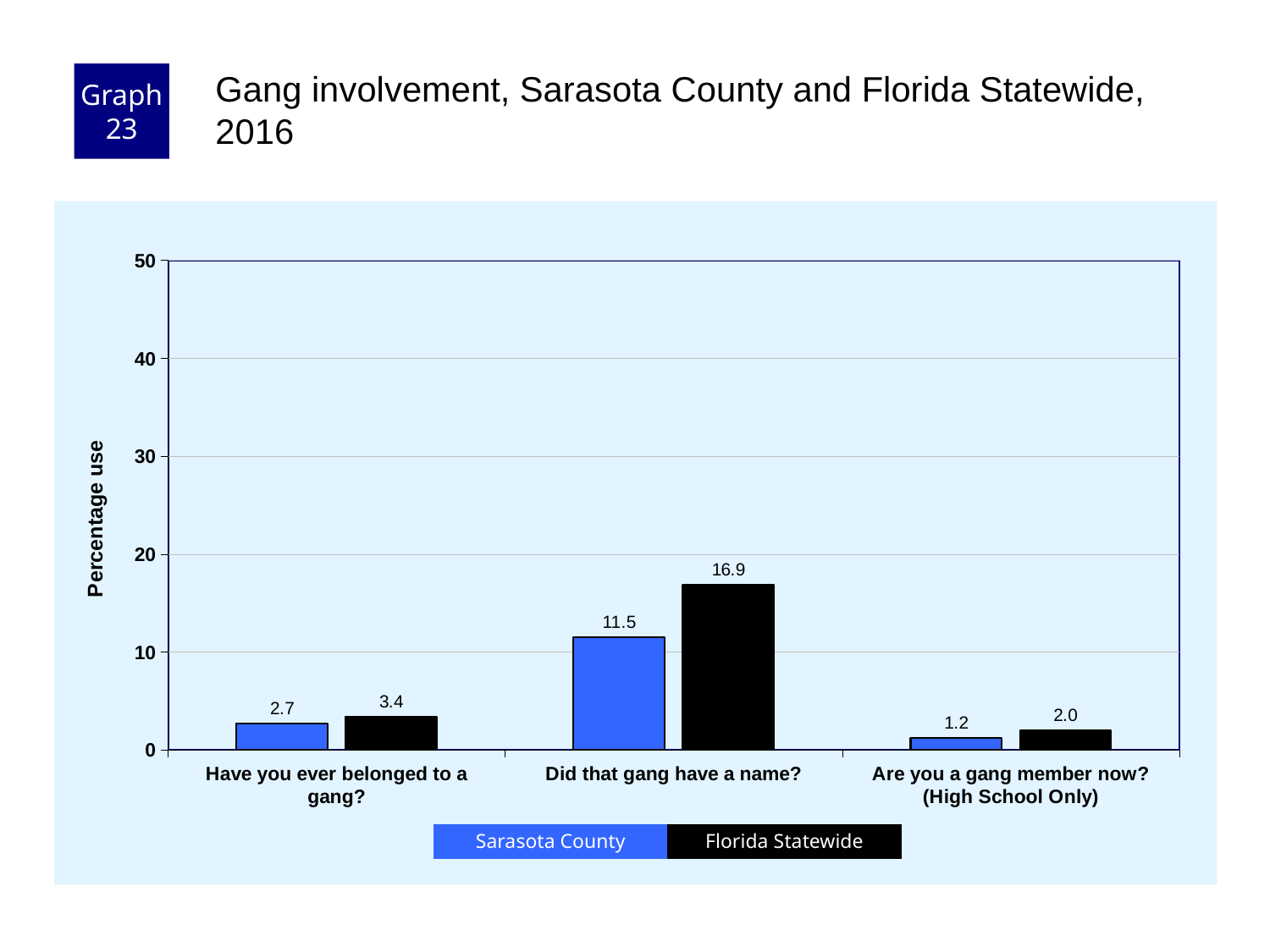
For "Have you ever belonged to a gang?", which is larger: Sarasota County or Florida Statewide? Florida Statewide Which question has the lowest Sarasota County value? Are you a gang member now? (High School Only) How many series does the legend list? 2 What is the Sarasota County value for "Did that gang have a name?"? 11.5 Is the Florida Statewide value for "Did that gang have a name?" greater or less than 20? less What is the Sarasota County value for "Are you a gang member now? (High School Only)"? 1.2 What kind of chart is shown? bar chart What is the difference between the Florida Statewide and Sarasota County values for "Did that gang have a name?"? 5.4 What is the label on the y axis? Percentage use How many questions (categories) are shown on the x axis? 3 What is the Florida Statewide value for "Have you ever belonged to a gang?"? 3.4 Which question has the highest Florida Statewide value? Did that gang have a name?